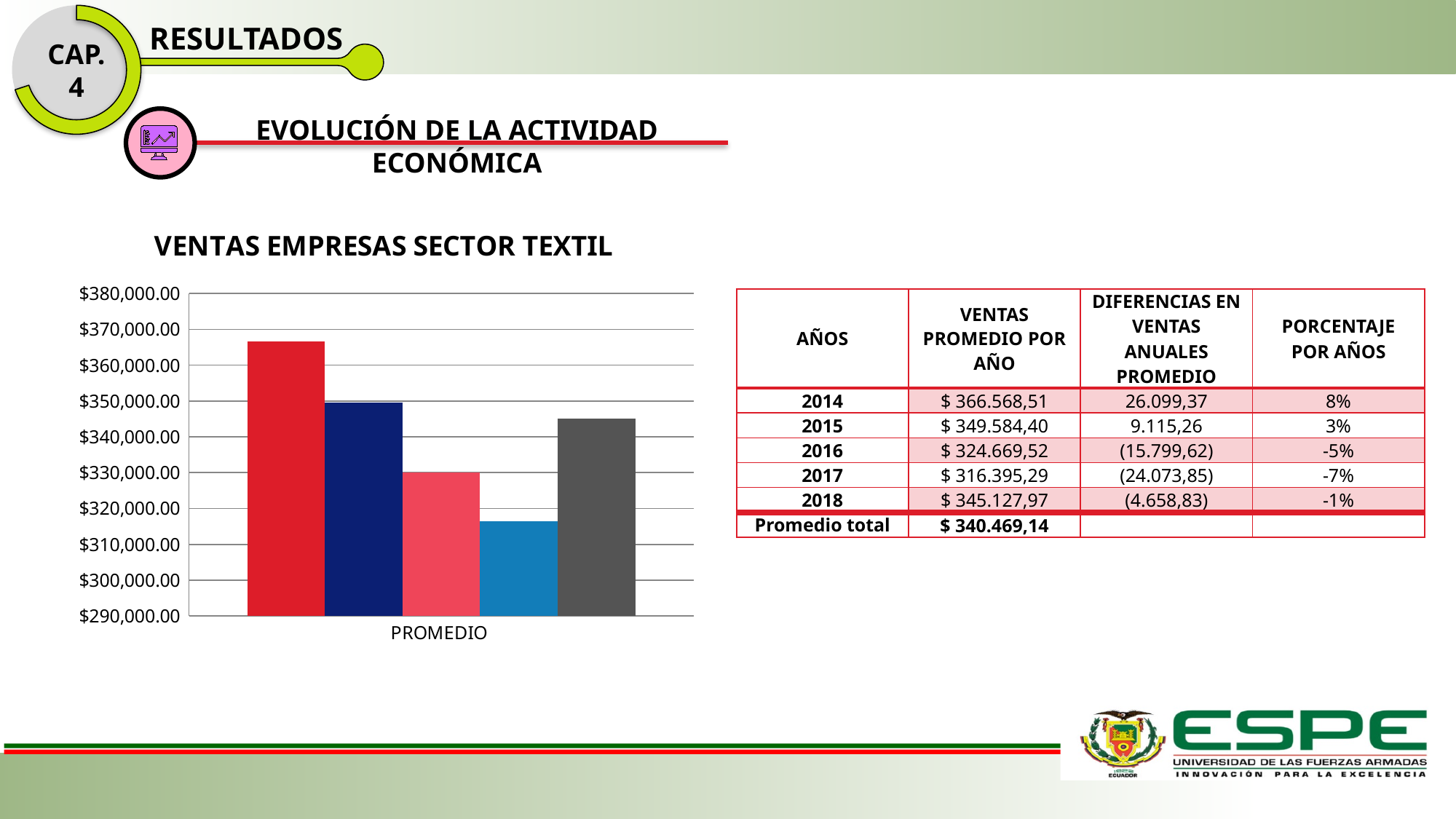
Is the value of the red bar greater or less than $360,000.00? greater Is the value of the pink bar greater or less than $340,000.00? less What kind of chart is shown on the slide? bar chart Which bar is the tallest in the chart? the red bar Which is taller, the navy bar or the pink bar? the navy bar Which bar is the shortest in the chart? the blue bar Which is taller, the gray bar or the blue bar? the gray bar What is the title of the chart? VENTAS EMPRESAS SECTOR TEXTIL What is the category label shown on the x axis of the chart? PROMEDIO How many bars are plotted in the chart? 5 Is the value of the blue bar greater or less than $320,000.00? less